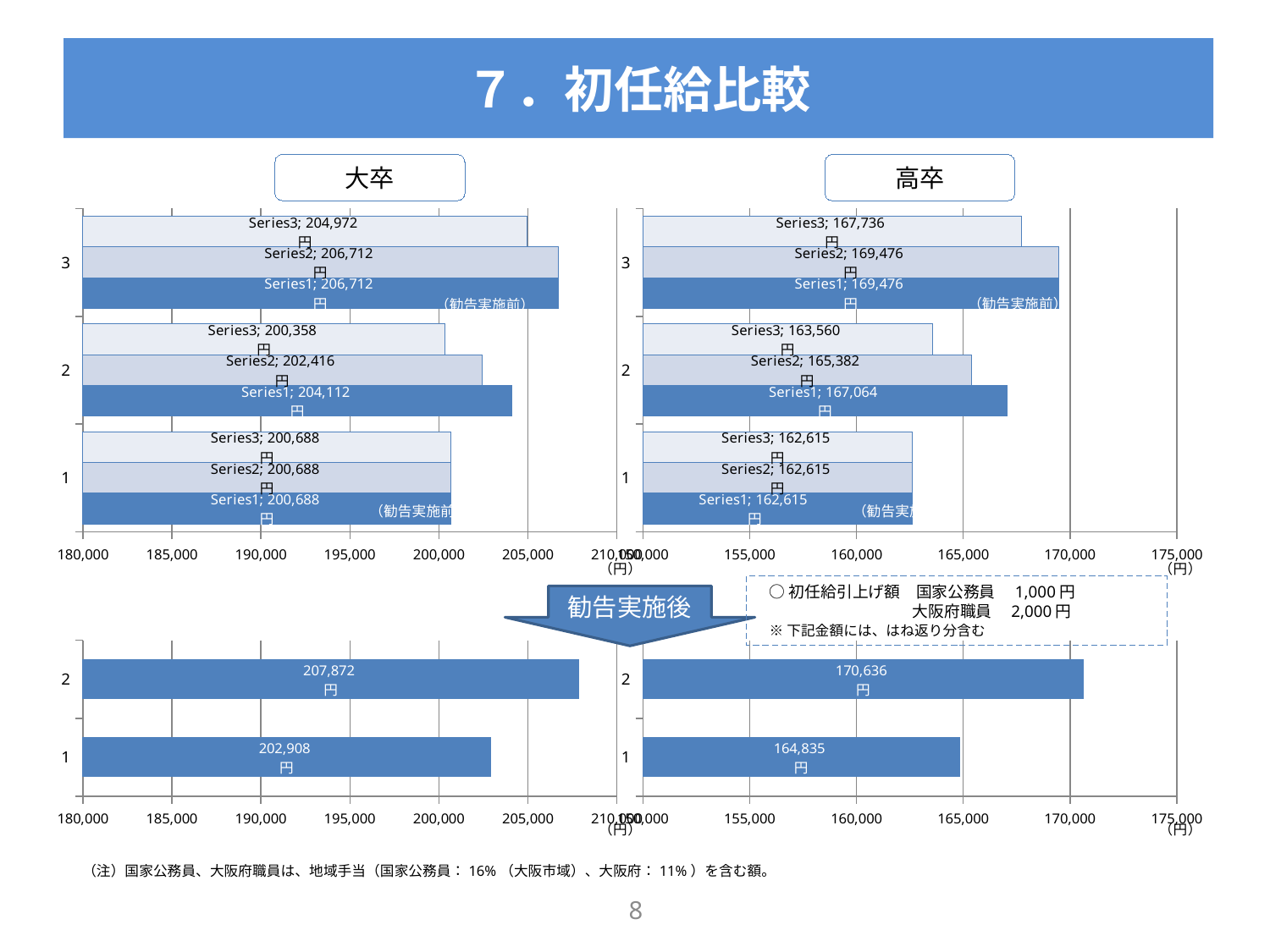
In the bottom-right chart (高卒, lower), which category has the higher value, 1 or 2? 2 In the bottom-left chart (大卒, lower), what is the difference between the values for category 2 and category 1? 4,964 円 What type of chart is the top-right chart (高卒, upper)? Bar chart In the top-left chart (大卒, upper), what is the value of Series1 for category 2? 204,112 円 In the top-right chart (高卒, upper), what is the value of Series1 for category 1? 162,615 円 In the top-right chart (高卒, upper), what is the value of Series2 for category 2? 165,382 円 How many categories are shown on the y axis of the bottom-left chart (大卒, lower)? 2 In the top-left chart (大卒, upper), which series has the lowest value for category 2? Series3 In the top-right chart (高卒, upper), what is the difference between Series1 and Series3 for category 3? 1,740 円 In the bottom-left chart (大卒, lower), what is the value for category 2? 207,872 円 In the bottom-right chart (高卒, lower), what is the value for category 1? 164,835 円 In the top-left chart (大卒, upper), what is the value of Series3 for category 3? 204,972 円